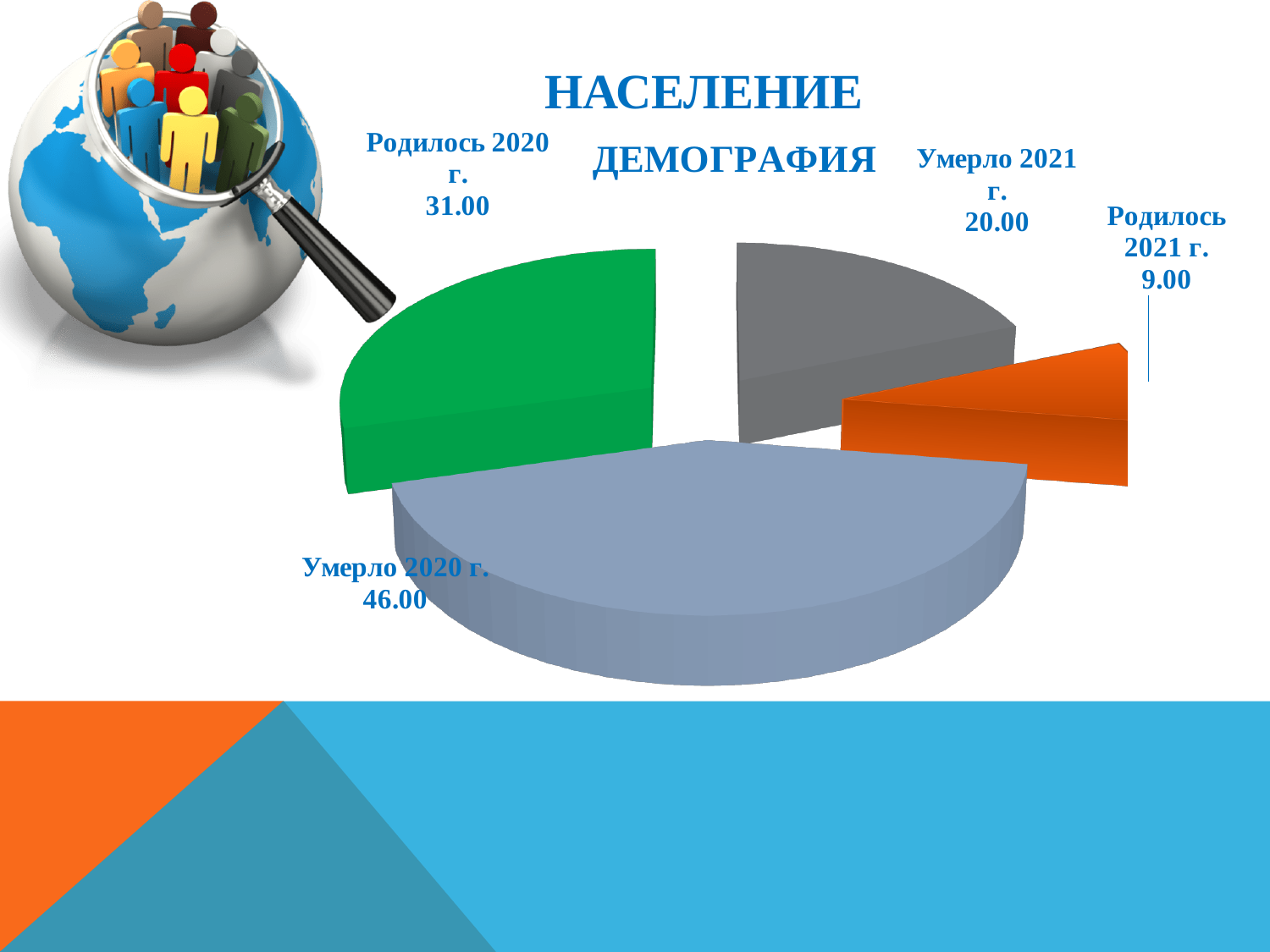
What is the difference between the values for Умерло 2020 г. and Умерло 2021 г.? 26.00 What is the value for Родилось 2021 г.? 9.00 What is the difference between the values for Родилось 2020 г. and Родилось 2021 г.? 22.00 Which category has the largest slice of the pie? Умерло 2020 г. Which category has the smallest slice of the pie? Родилось 2021 г. What is the title of the chart? ДЕМОГРАФИЯ What is the value for Умерло 2021 г.? 20.00 What kind of chart is shown on the slide? Pie chart How many slices does the pie chart have? 4 What is the value for Умерло 2020 г.? 46.00 Which is larger, the value for Родилось 2020 г. or the value for Умерло 2021 г.? Родилось 2020 г. What is the value for Родилось 2020 г.? 31.00